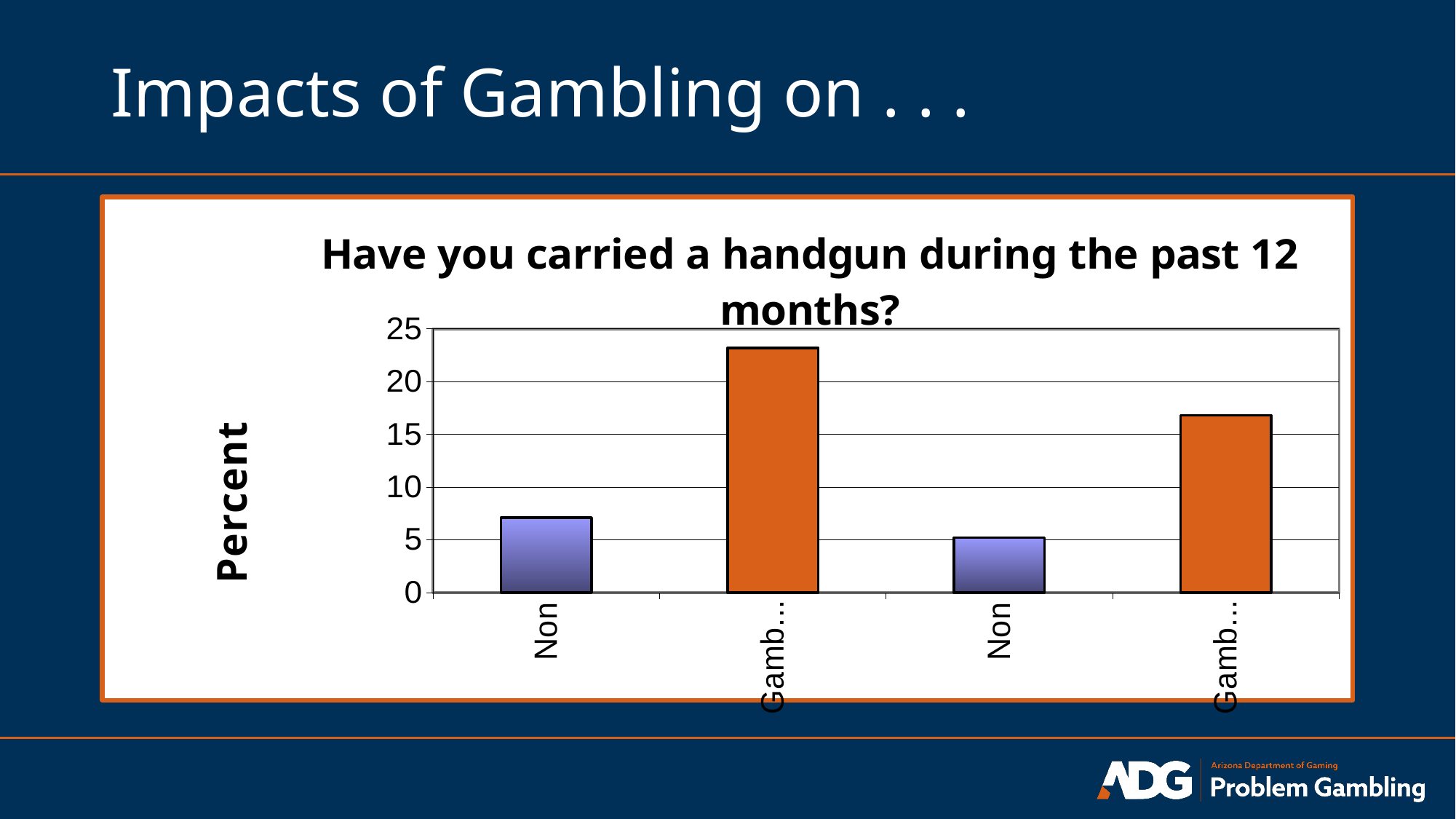
Which bar is the lowest in the chart? the third bar (Non) What is the title of the chart? Have you carried a handgun during the past 12 months? Is the value of the fourth bar (Gamb...) greater or less than 15? greater What kind of chart is shown on the slide? bar chart What is the label on the vertical axis of the chart? Percent Which bar is the highest in the chart? the second bar (Gamb...) Which is larger, the first bar (Non) or the third bar (Non)? the first bar Is the value of the first bar (Non) greater or less than 5? greater How many bars are plotted in the chart? 4 Is the value of the second bar (Gamb...) greater or less than 20? greater Which is larger, the second bar or the fourth bar? the second bar